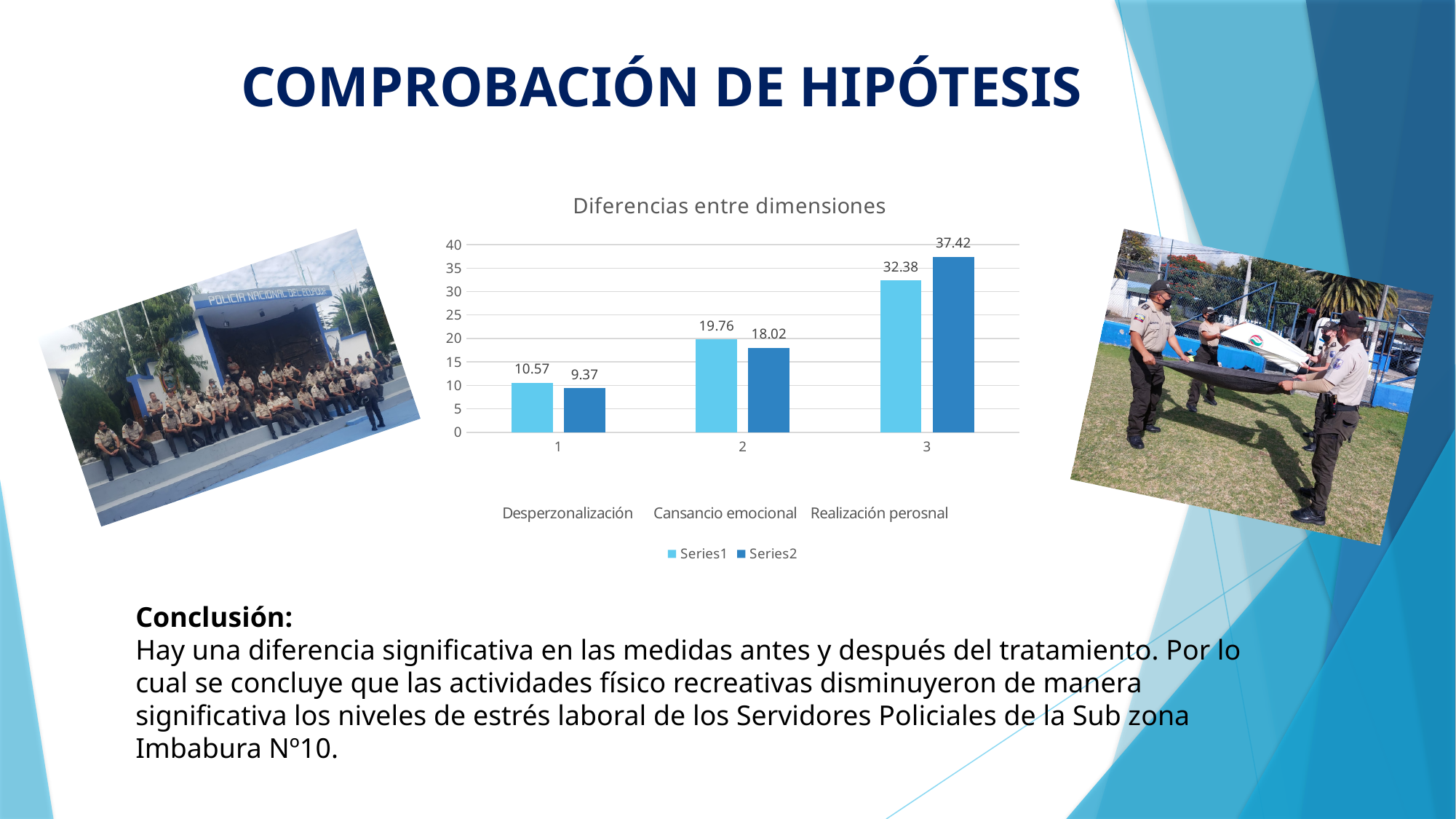
How many categories are shown on the x axis of the chart? 3 For category 2, which is larger, Series1 or Series2? Series1 Do the Series1 values rise or fall from category 1 to category 3? rise Which category has the lowest Series2 value? 1 What type of chart is shown on the slide? bar chart What is the title of the chart? Diferencias entre dimensiones What is the value of Series2 for category 3? 37.42 How many series does the chart legend list? 2 What is the value of Series1 for category 1? 10.57 What is the value of Series2 for category 2? 18.02 What is the difference between Series2 and Series1 for category 3? 5.04 Which category has the highest Series1 value? 3